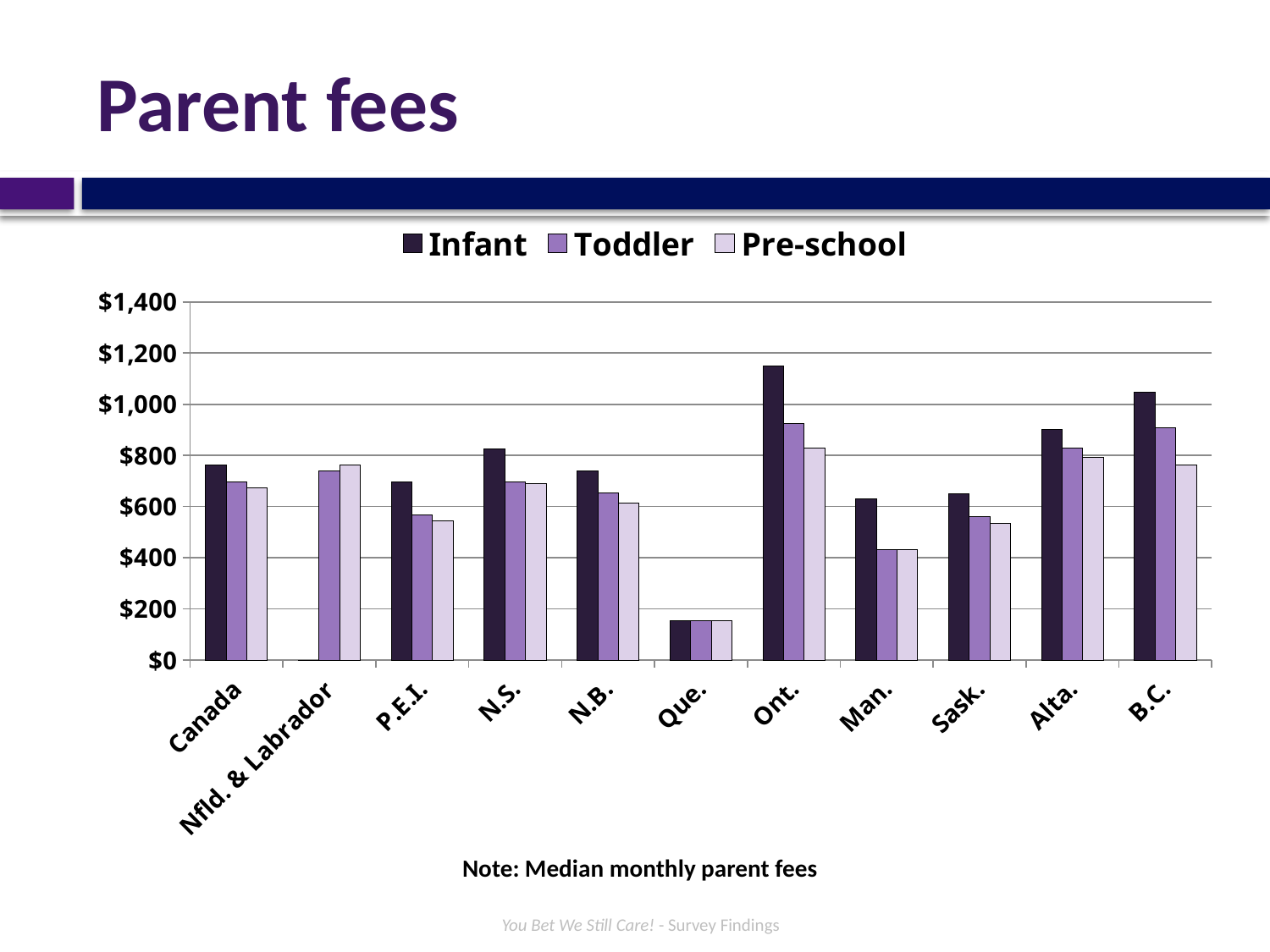
Is the Infant value for Alta. greater or less than $800? greater How many categories are shown along the x axis? 11 Which is larger, the Infant value for Ont. or the Infant value for B.C.? Ont. Which is larger, the Toddler value for Man. or the Toddler value for Sask.? Sask. Is the Infant value for Ont. greater or less than $1,000? greater Which category has the lowest Toddler fee? Que. What kind of chart is shown on the slide? bar chart What does the note below the chart say the values represent? Median monthly parent fees Which category has the highest Infant fee? Ont. Is the Infant value for Que. greater or less than $200? less How many series does the legend list? 3